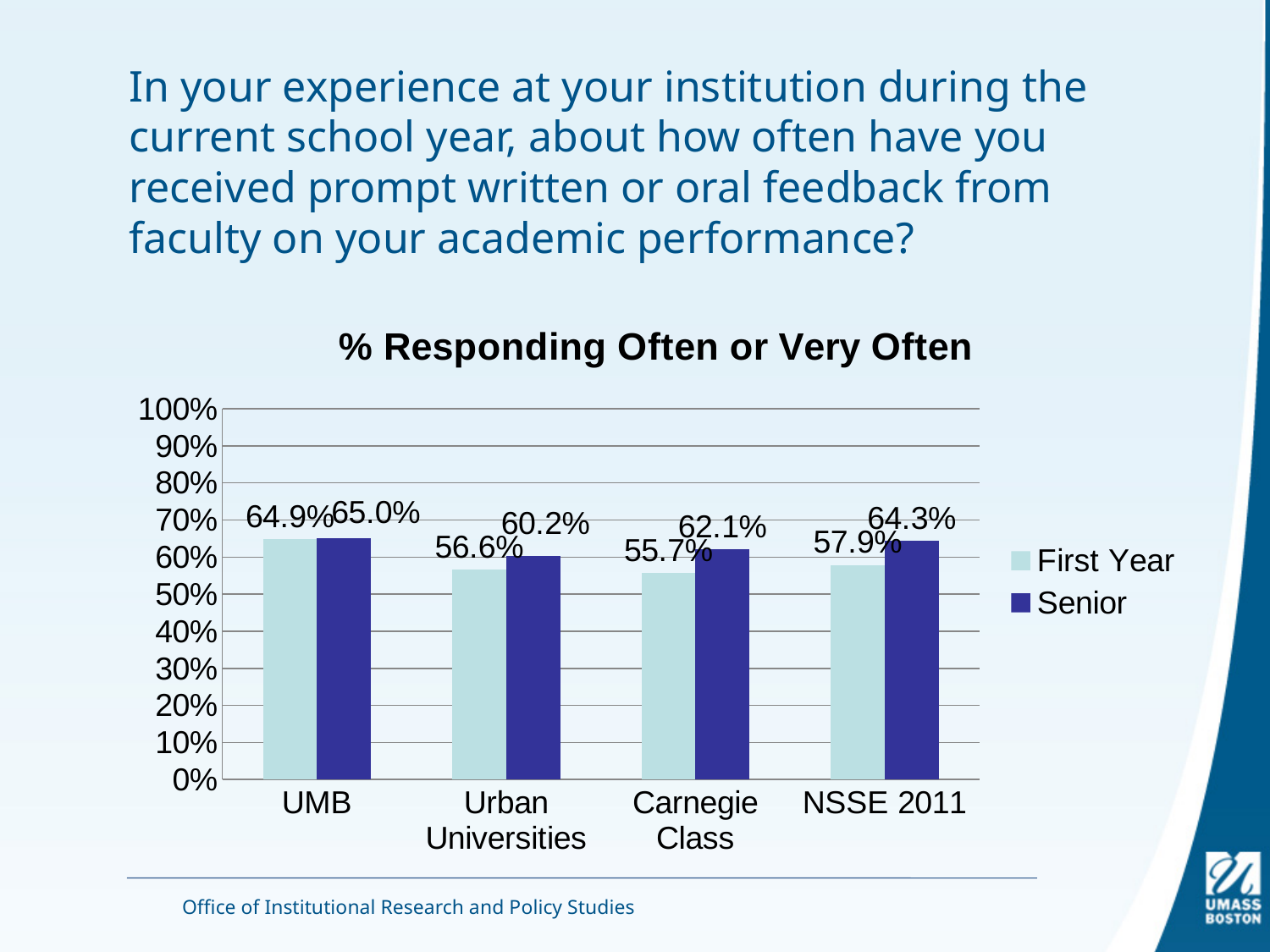
What kind of chart is shown on the slide? Bar chart How many categories are shown on the x axis? 4 What is the First Year value for UMB? 64.9% What is the Senior value for Carnegie Class? 62.1% Which is larger, the First Year value for UMB or the First Year value for Urban Universities? UMB How many series does the legend list? 2 What is the First Year value for NSSE 2011? 57.9% What is the difference between the Senior and First Year values for Carnegie Class? 6.4% What is the difference between the Senior and First Year values for NSSE 2011? 6.4% What is the Senior value for Urban Universities? 60.2% Which category has the lowest First Year value? Carnegie Class Which category has the highest Senior value? UMB